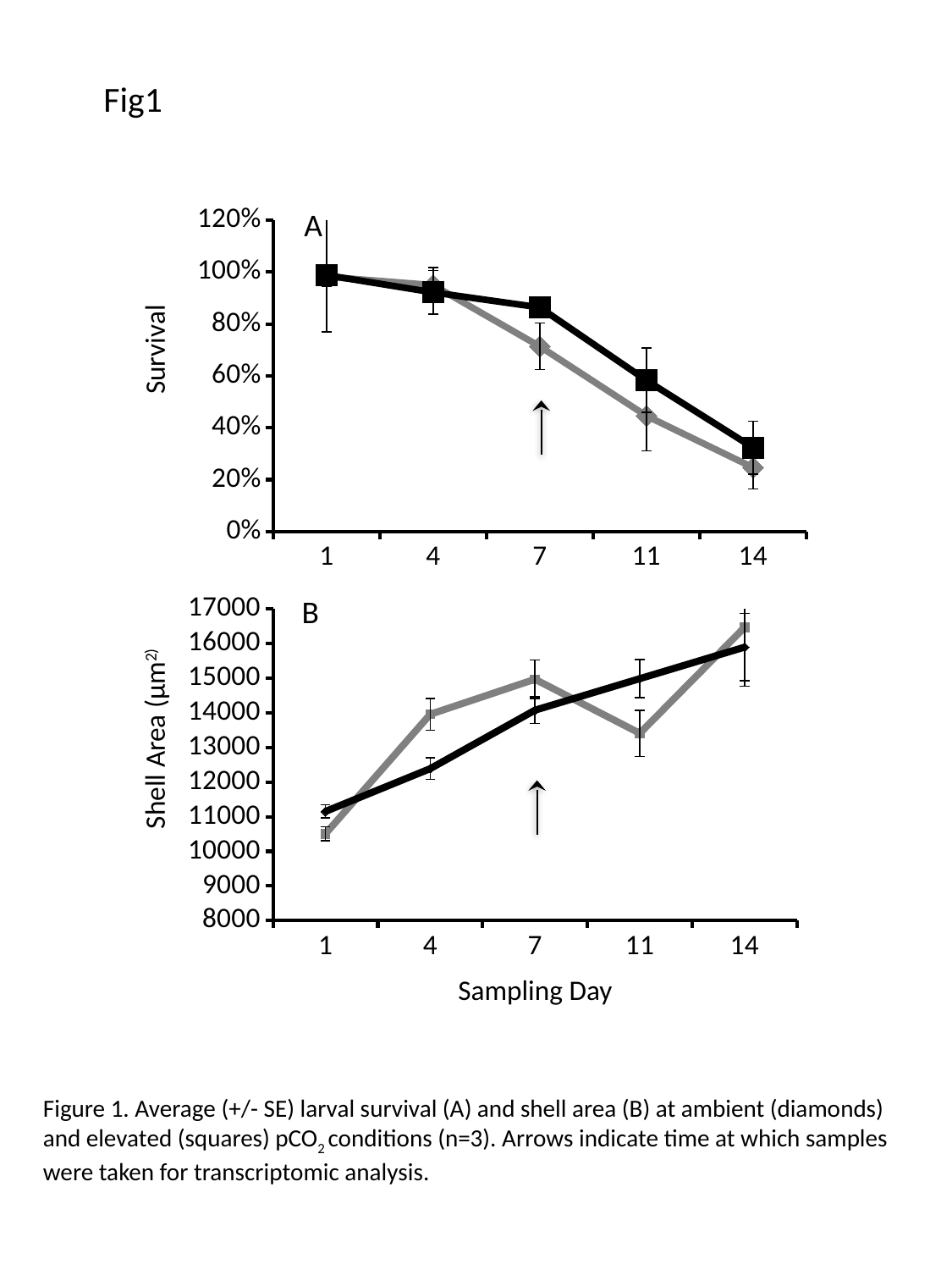
In chart A (Survival), is the value of the black squares series at day 14 greater or less than 40%? less What is the y-axis label of chart B? Shell Area (µm²) In chart B (Shell Area), is the value of the gray squares series at day 14 greater or less than 16000? greater In chart A (Survival), is the value of the gray diamonds series at day 11 greater or less than 60%? less In chart A (Survival), how many sampling days are plotted on the x axis? 5 What kind of chart is chart A (Survival)? line chart In chart B (Shell Area), at which sampling day is the gray squares series lowest? 1 In chart B (Shell Area), which series has the higher value at day 11, the black diamonds or the gray squares? black diamonds In chart A (Survival), which series has the higher value at day 7, the black squares or the gray diamonds? black squares In chart A (Survival), do the survival values rise or fall from day 1 to day 14? fall